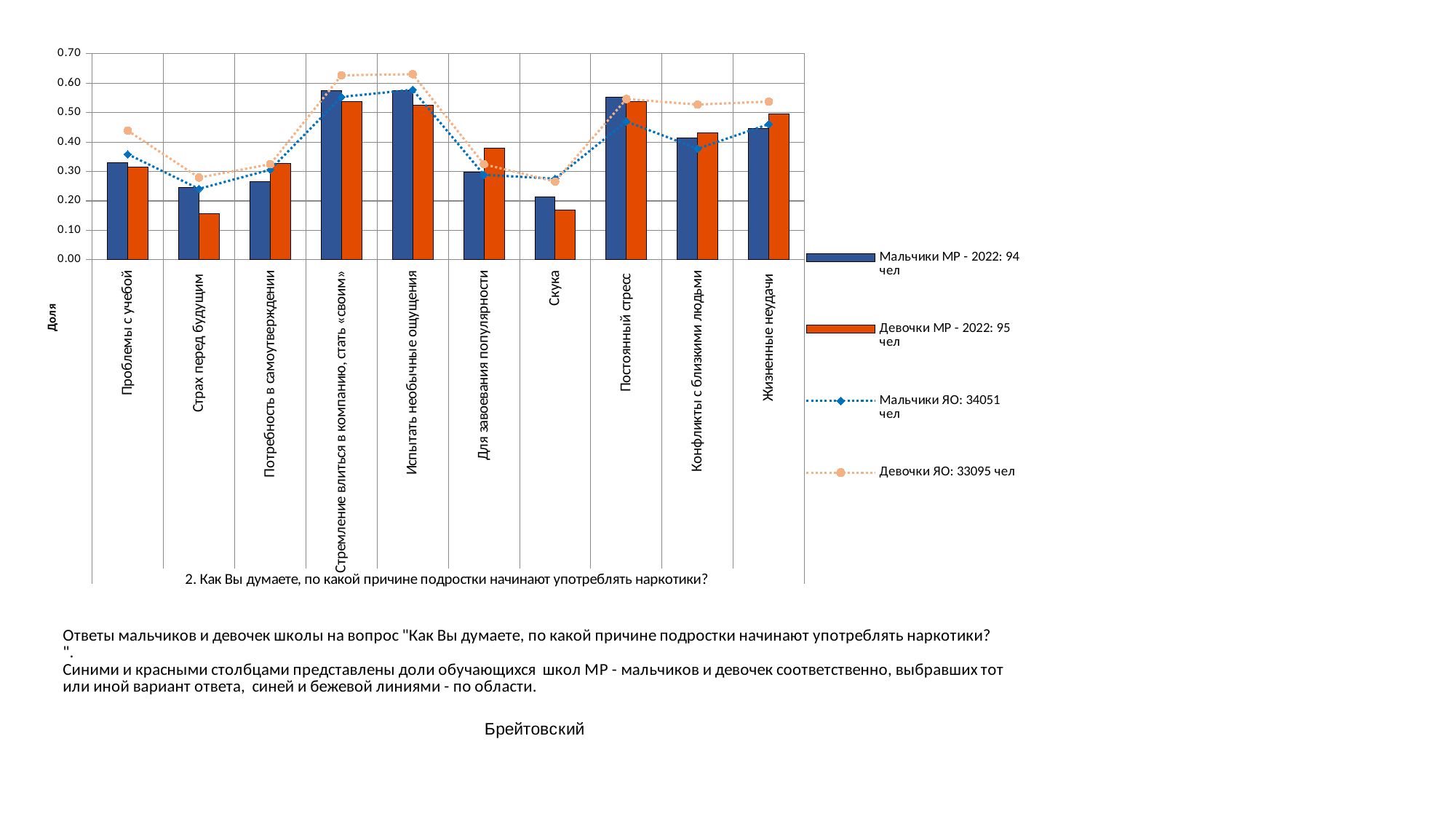
How many series does the chart's legend list? 4 What kind of chart is shown on the slide? bar chart with line series Is the value for Проблемы с учебой in the Девочки ЯО series greater or less than 0.40? greater For Страх перед будущим, which is larger: the Мальчики МР - 2022 bar or the Девочки МР - 2022 bar? Мальчики МР - 2022 Is the value for Стремление влиться в компанию, стать «своим» in the Девочки ЯО series greater or less than 0.60? greater According to the legend, how many people are in the Мальчики ЯО group? 34051 чел For Для завоевания популярности, which is larger: the Мальчики МР - 2022 bar or the Девочки МР - 2022 bar? Девочки МР - 2022 Which category has the lowest value for the Мальчики МР - 2022 series? Скука Is the value for Постоянный стресс in the Мальчики МР - 2022 series greater or less than 0.50? greater How many categories are shown on the x axis of the chart? 10